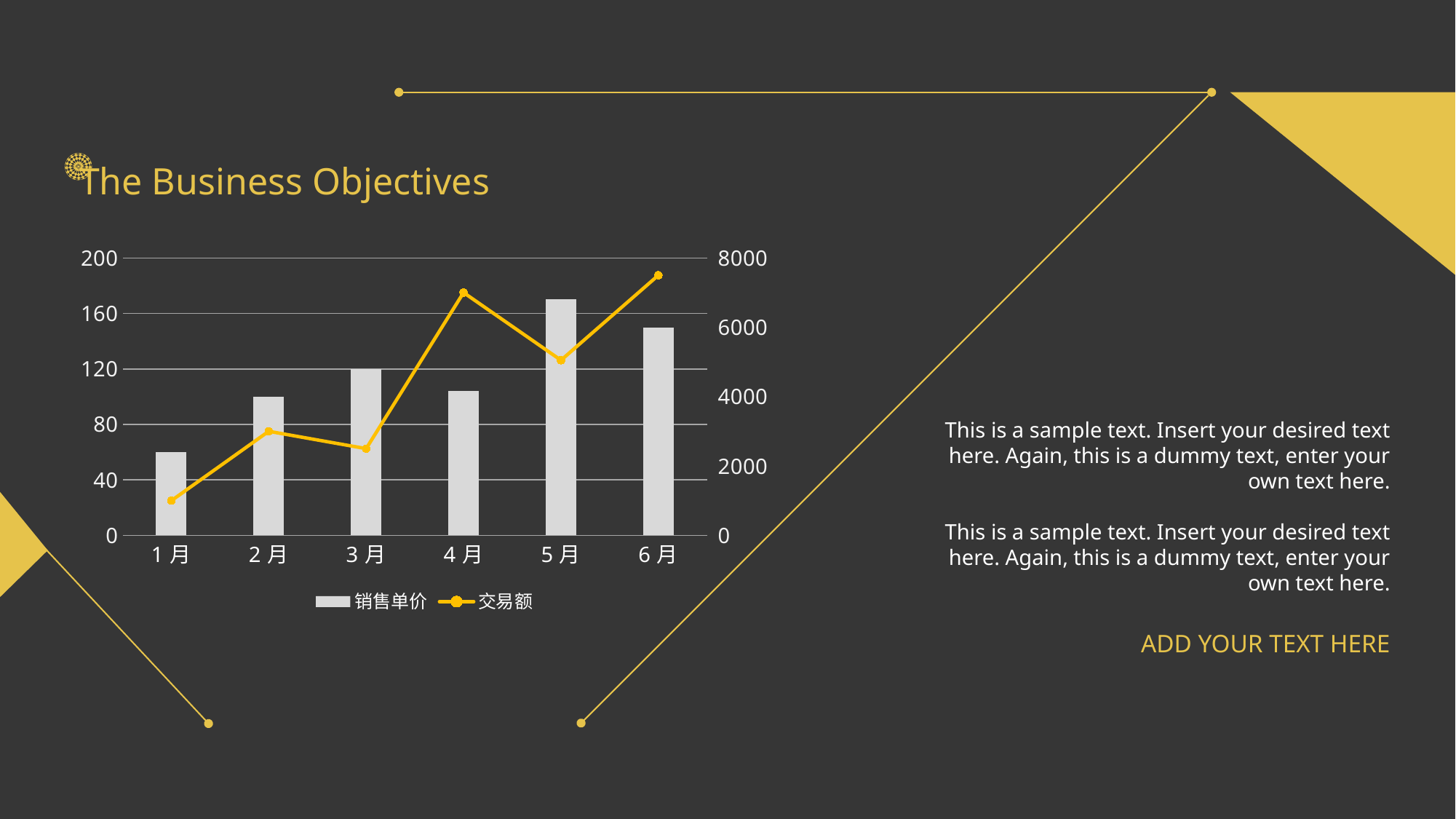
Is the 交易额 value for 4月 greater or less than 6000? greater Which month has the highest point on the 交易额 line? 6月 How many series does the chart legend list? 2 Is the 销售单价 bar for 5月 greater or less than 160? greater Is the 交易额 value for 5月 greater or less than 6000? less Which month has the lowest point on the 交易额 line? 1月 Which has the taller 销售单价 bar, 3月 or 6月? 6月 How many months are shown on the x axis of the chart? 6 Which month has the tallest bar for 销售单价? 5月 Which month has the shortest bar for 销售单价? 1月 What kind of chart is shown on the slide? A combination bar and line chart